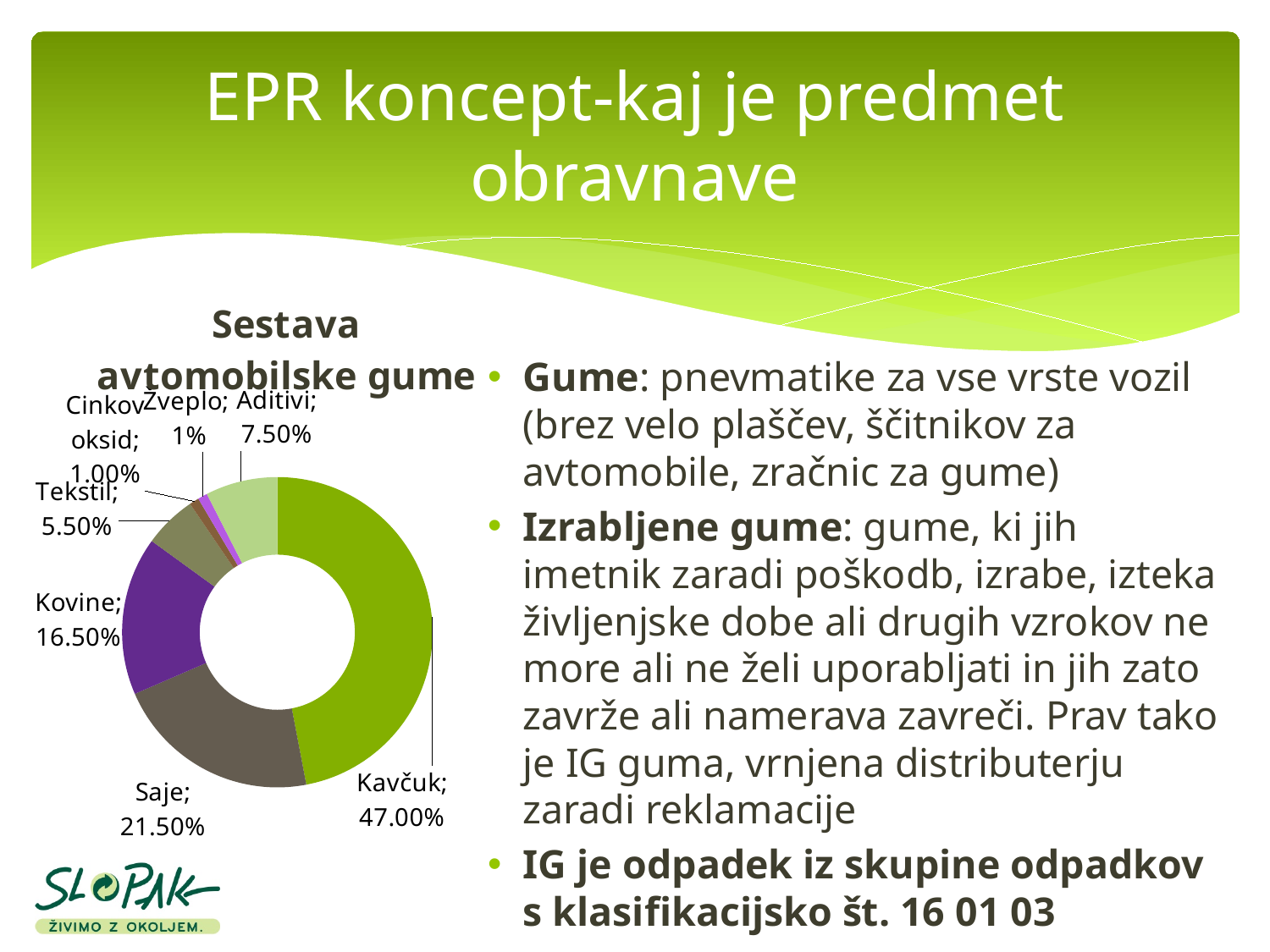
What share of the tyre composition is Kavčuk? 47.00% What is the value shown for Tekstil? 5.50% What is the difference between the shares of Kavčuk and Saje? 25.50% Which component has the largest share in the chart? Kavčuk What is the value shown for Kovine? 16.50% What is the value shown for Aditivi? 7.50% What type of chart is shown on the slide? doughnut chart What is the title of the chart? Sestava avtomobilske gume What is the combined share of Cinkov oksid and Žveplo? 2% How many components (slices) does the chart show? 7 Which is larger, the share of Kovine or the share of Aditivi? Kovine What is the value shown for Saje? 21.50%